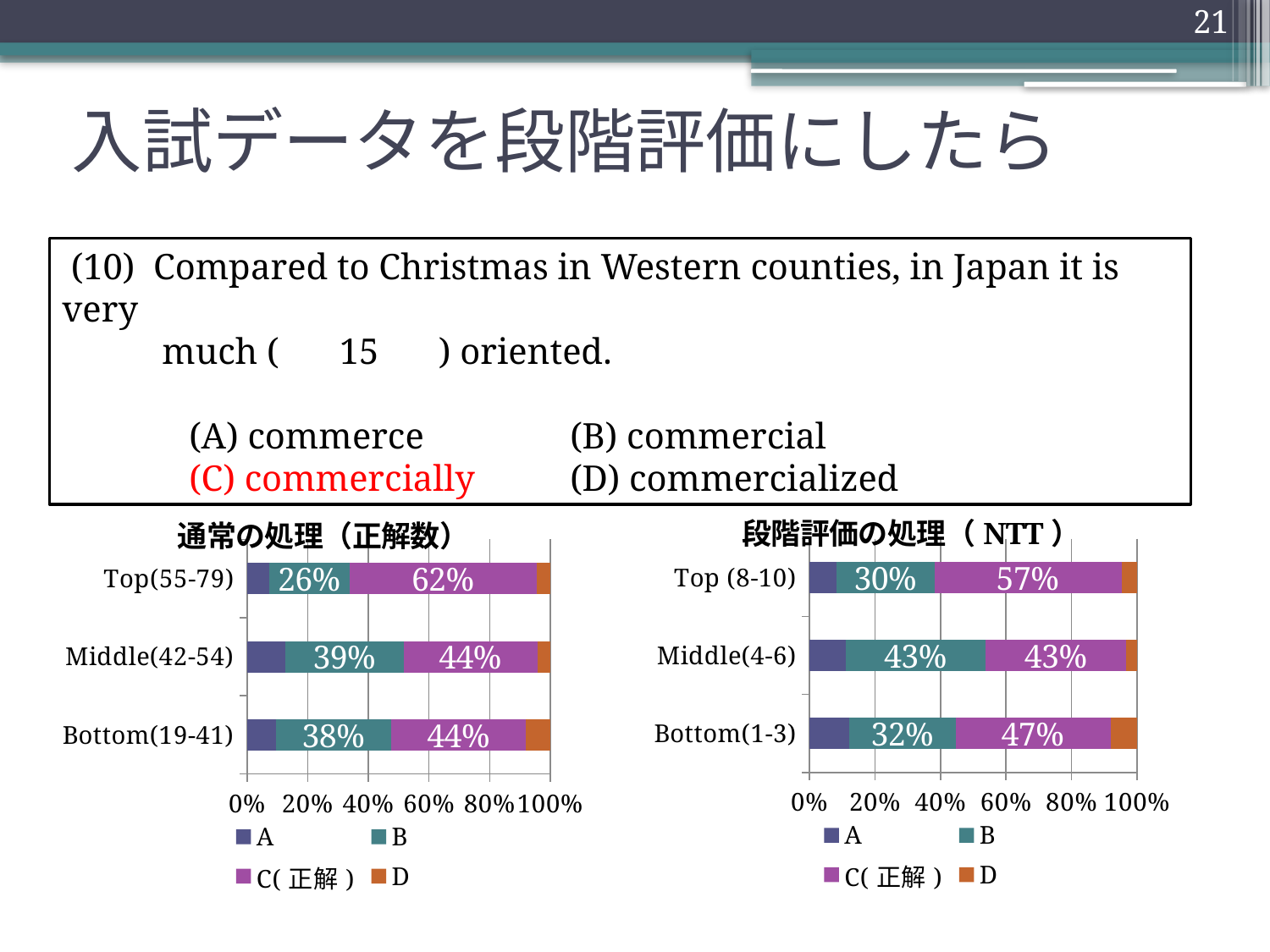
In the left chart (通常の処理（正解数）), which category has the highest value for C(正解)? Top(55-79) How many categories are shown in the right chart (段階評価の処理（NTT）)? 3 In the right chart (段階評価の処理（NTT）), which category has the lowest value for B? Top (8-10) How many series does the legend of the left chart (通常の処理（正解数）) list? 4 In the right chart (段階評価の処理（NTT）), what is the value for C(正解) in the Bottom(1-3) category? 47% In the right chart (段階評価の処理（NTT）), what is the difference between the C(正解) value for Top (8-10) and the B value for Top (8-10)? 27% In the left chart (通常の処理（正解数）), what is the value for B in the Middle(42-54) category? 39% In the left chart (通常の処理（正解数）), what is the difference between the C(正解) value for Top(55-79) and for Middle(42-54)? 18% In the left chart (通常の処理（正解数）), is the value for A in the Top(55-79) category greater or less than 20%? less In the right chart (段階評価の処理（NTT）), what is the value for B in the Top (8-10) category? 30% In the right chart (段階評価の処理（NTT）), which is larger for Bottom(1-3): the value for B or the value for C(正解)? C(正解) In the left chart (通常の処理（正解数）), what is the value for C(正解) in the Top(55-79) category? 62%